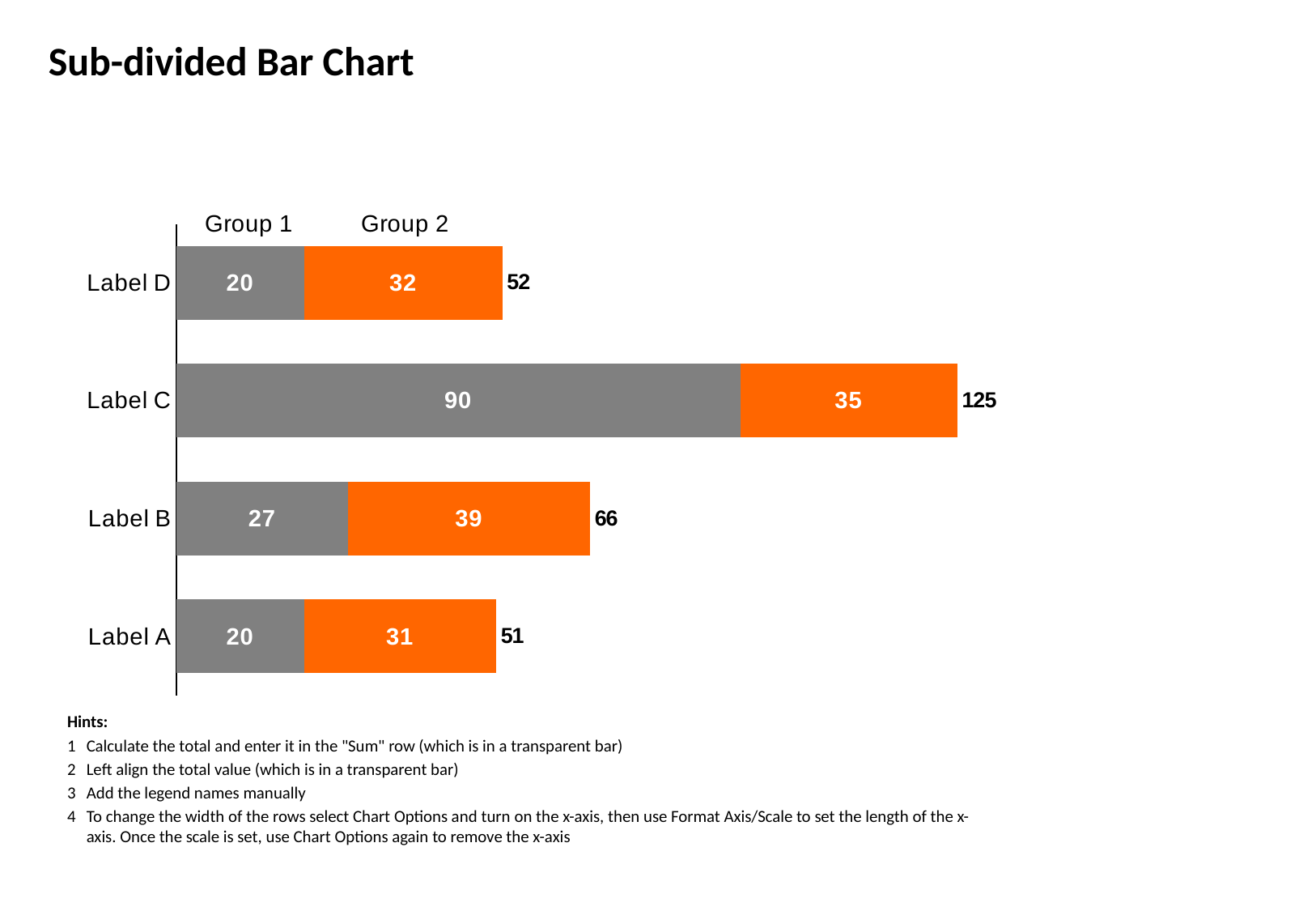
Which colour represents Group 2? Orange What is the title of the slide? Sub-divided Bar Chart How many labels (categories) are shown in the chart? 4 How many groups (series) does the chart show? 2 What is the total shown for Label D? 52 What is the difference between the Group 2 values for Label B and Label A? 8 Which label has the highest total? Label C What kind of chart is shown on the slide? Stacked bar chart What is the Group 1 value for Label C? 90 Which label has the lowest total? Label A Which is larger, the Group 1 value for Label B or the Group 1 value for Label D? Label B What is the Group 2 value for Label B? 39